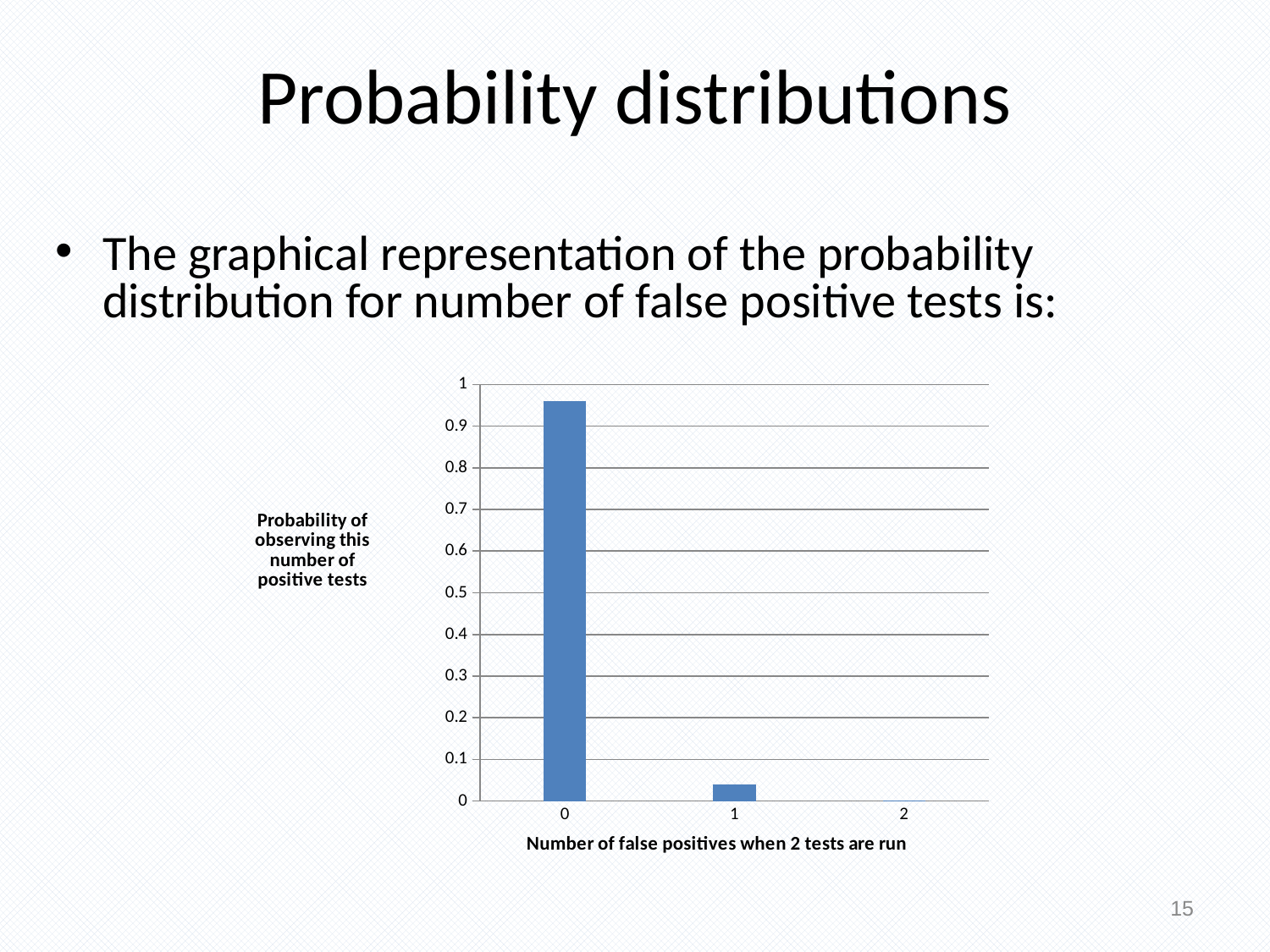
How many categories are shown on the x axis of the chart? 3 What is the label on the vertical axis of the chart? Probability of observing this number of positive tests What kind of chart is shown on the slide? bar chart Which number of false positives has the highest probability in the chart? 0 Do the probabilities rise or fall as the number of false positives increases along the x axis? fall Is the probability for 0 false positives greater or less than 0.5? greater What is the title of the x axis of the chart? Number of false positives when 2 tests are run Which number of false positives has the lowest probability in the chart? 2 Is the probability for 1 false positive greater or less than 0.1? less Is the probability for 0 false positives greater or less than 0.9? greater Which has a larger probability: 0 false positives or 1 false positive? 0 false positives